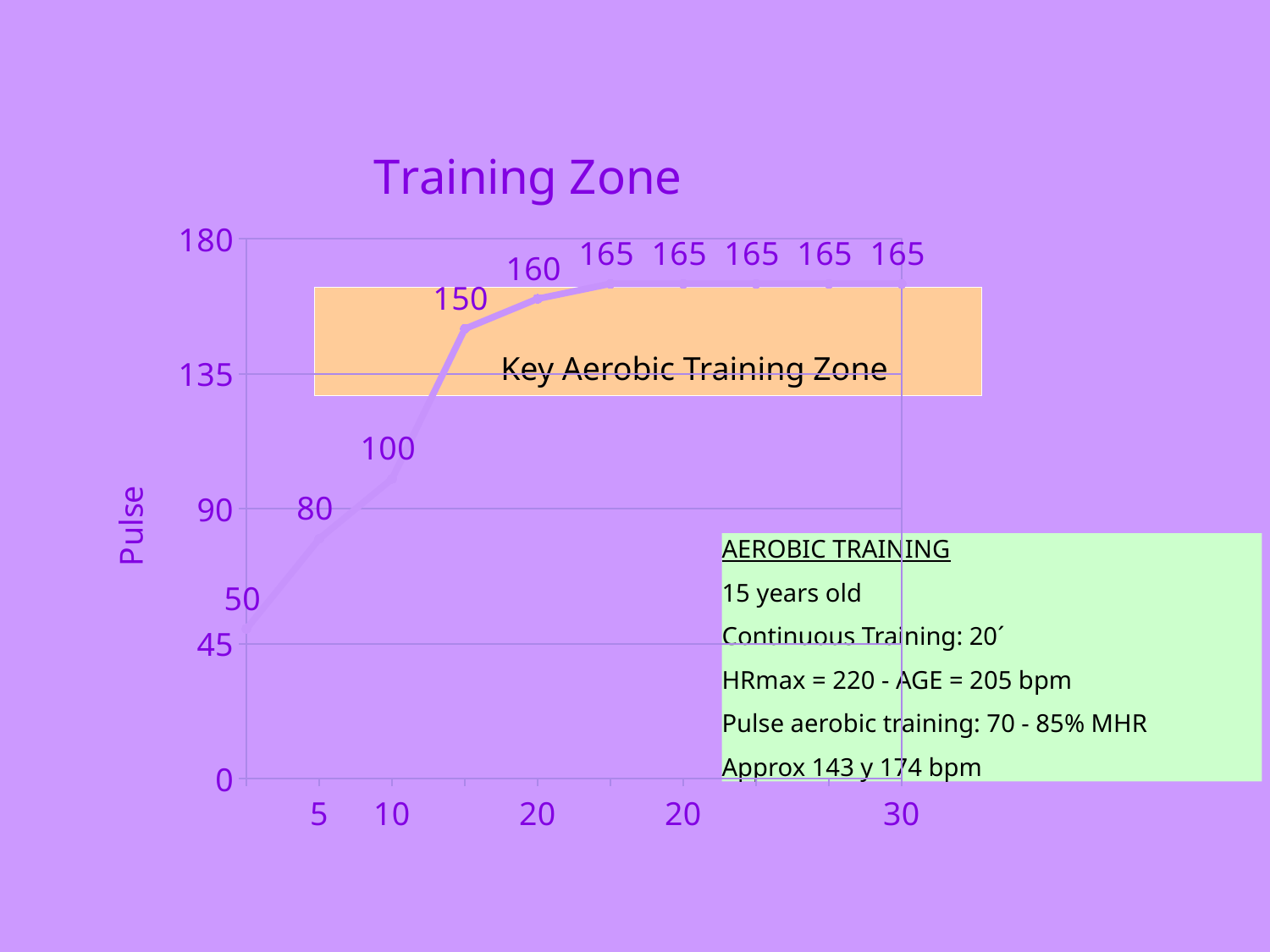
What is the lowest pulse value plotted on the chart? 50 What kind of chart is shown on the slide? line chart What is the pulse value at x = 5? 80 Which is larger, the pulse value labelled 150 or the one labelled 100? 150 What is the pulse value at x = 10? 100 What is the highest pulse value plotted on the chart? 165 Does the pulse rise or fall along the x axis before it levels off? rise What is the pulse value at x = 30? 165 What is the difference between the highest and lowest pulse values on the chart? 115 What is the label on the vertical axis of the chart? Pulse What is the title of the chart? Training Zone How many data points are plotted on the line? 10